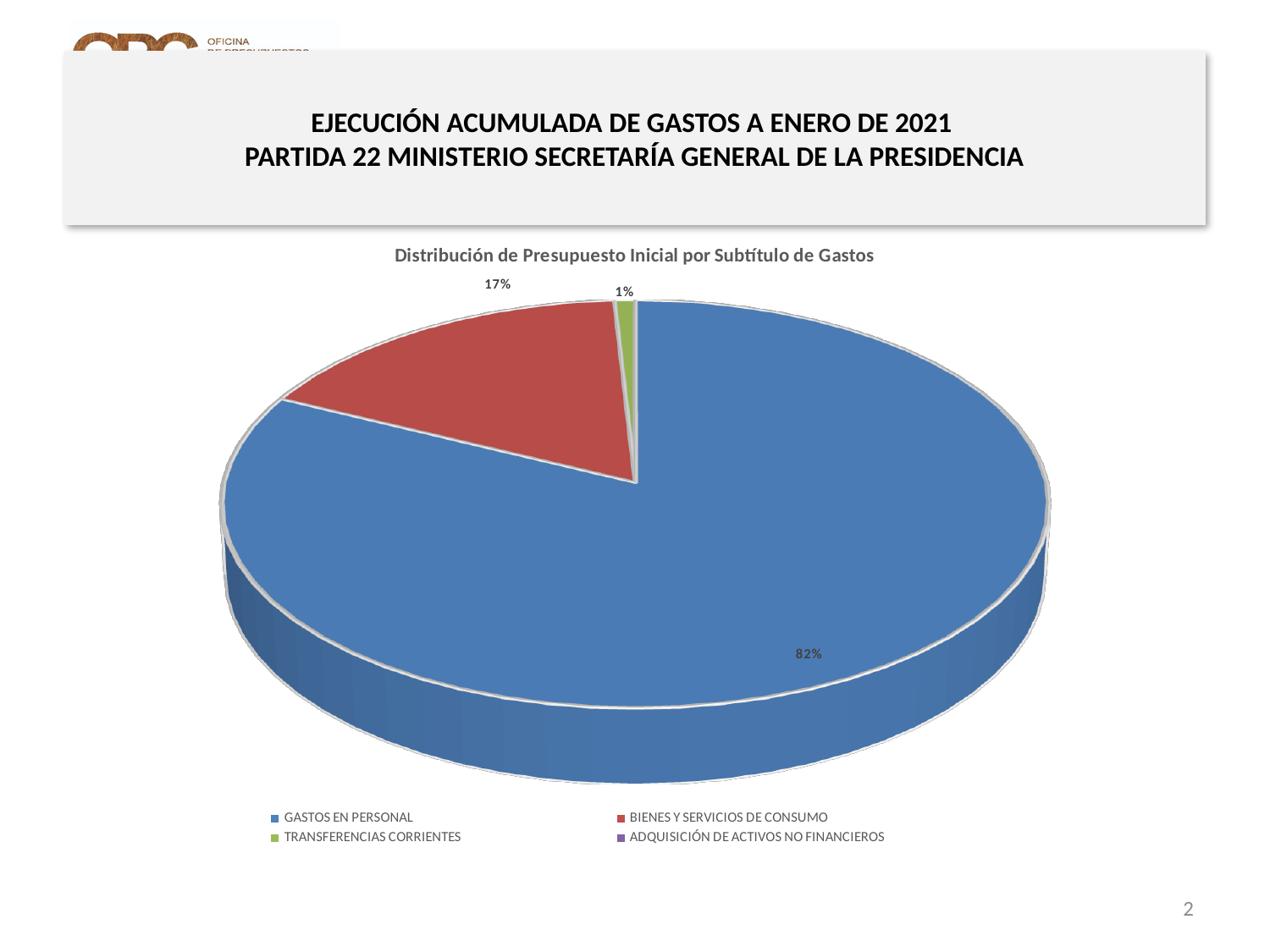
What share of the pie does TRANSFERENCIAS CORRIENTES represent? 1% Which is larger, the share for BIENES Y SERVICIOS DE CONSUMO or the share for TRANSFERENCIAS CORRIENTES? BIENES Y SERVICIOS DE CONSUMO What is the difference in percentage points between the GASTOS EN PERSONAL slice and the BIENES Y SERVICIOS DE CONSUMO slice? 65 percentage points What is the title of the chart? Distribución de Presupuesto Inicial por Subtítulo de Gastos Is the share for GASTOS EN PERSONAL greater or less than 50%? greater How many entries does the legend list? 4 What colour is the slice for BIENES Y SERVICIOS DE CONSUMO? red How many slices have a percentage label printed on the chart? 3 What share of the pie does BIENES Y SERVICIOS DE CONSUMO represent? 17% Which category has the largest slice of the pie? GASTOS EN PERSONAL What share of the pie does GASTOS EN PERSONAL represent? 82% What kind of chart is shown on the slide? pie chart